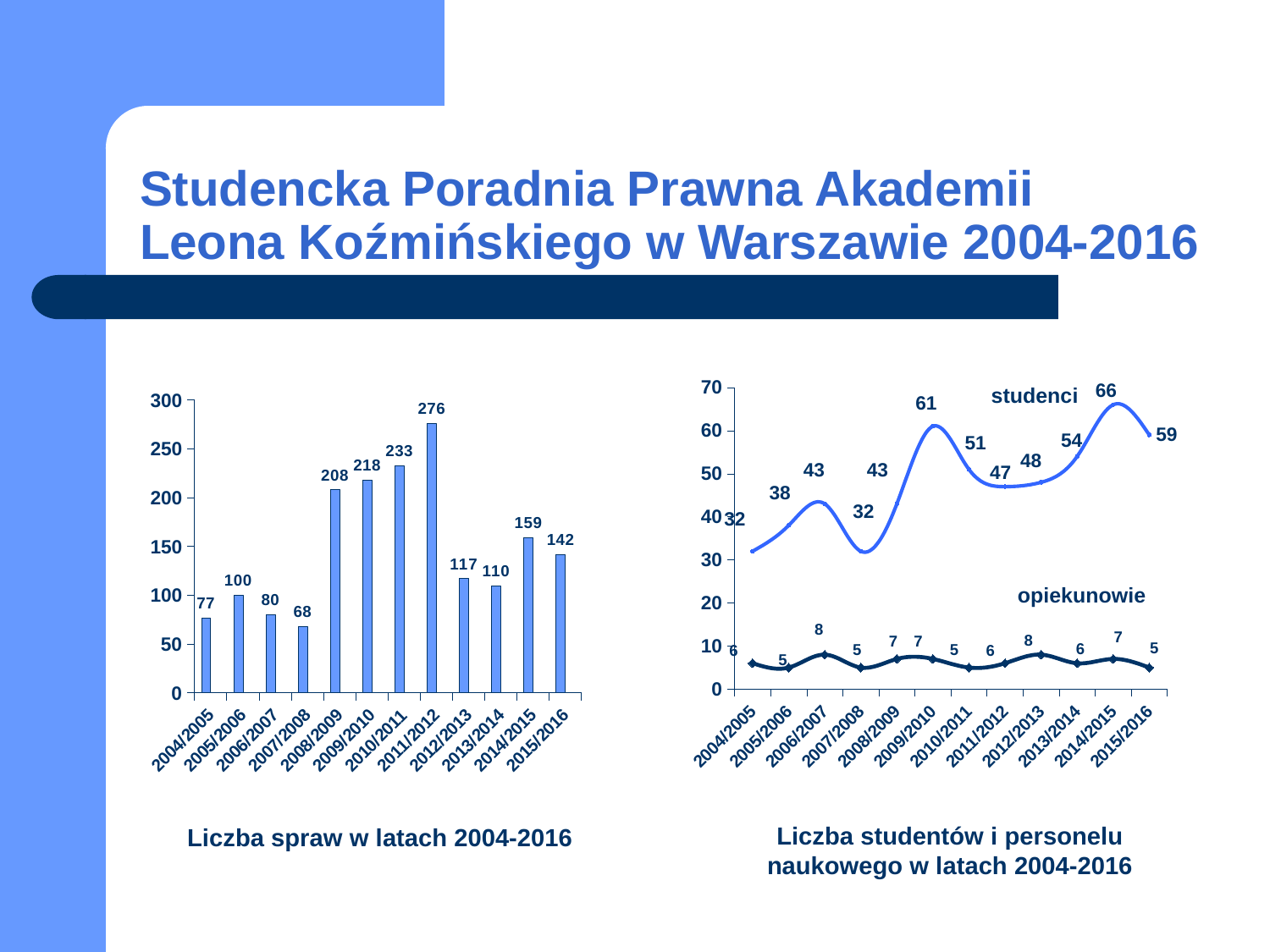
In the left chart (Liczba spraw w latach 2004-2016), which year has the lowest value? 2007/2008 In the right chart (Liczba studentów i personelu naukowego), what is the difference between studenci and opiekunowie in 2015/2016? 54 What kind of chart is the right chart (Liczba studentów i personelu naukowego)? line chart In the left chart (Liczba spraw w latach 2004-2016), how many years are shown on the x axis? 12 In the right chart (Liczba studentów i personelu naukowego), which year has the highest value for studenci? 2014/2015 In the right chart (Liczba studentów i personelu naukowego), what is the value for studenci in 2009/2010? 61 How many series are plotted in the right chart (Liczba studentów i personelu naukowego)? 2 In the left chart (Liczba spraw w latach 2004-2016), which is larger, the value for 2012/2013 or 2013/2014? 2012/2013 What kind of chart is the left chart (Liczba spraw w latach 2004-2016)? bar chart In the left chart (Liczba spraw w latach 2004-2016), what is the value for 2011/2012? 276 In the left chart (Liczba spraw w latach 2004-2016), what is the difference between the values for 2014/2015 and 2015/2016? 17 In the right chart (Liczba studentów i personelu naukowego), what is the value for opiekunowie in 2012/2013? 8